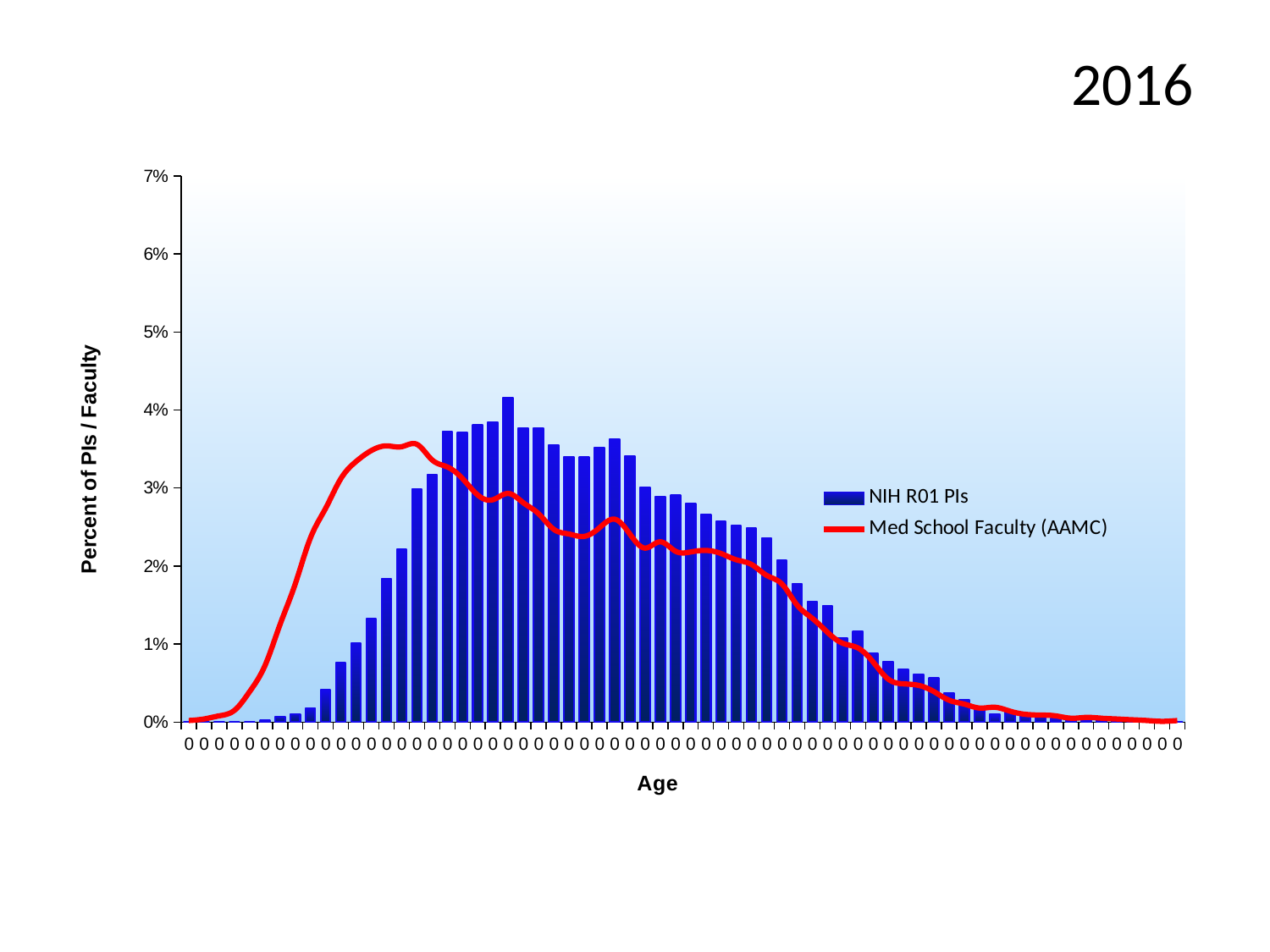
Toward the right end of the x axis, do the NIH R01 PIs bars rise or fall? fall What are the two series named in the legend? NIH R01 PIs and Med School Faculty (AAMC) What kind of chart is shown on the slide? A bar chart combined with a line chart What is the title of the vertical axis? Percent of PIs / Faculty Which series rises first along the x axis, the bars or the red line? Med School Faculty (AAMC) Is the peak of the Med School Faculty (AAMC) line greater or less than 3%? greater Which series is drawn as a red line rather than bars? Med School Faculty (AAMC) How many series does the legend list? 2 Is the tallest NIH R01 PIs bar greater or less than 4%? greater Which series reaches a higher peak value, NIH R01 PIs or Med School Faculty (AAMC)? NIH R01 PIs Is the peak of the Med School Faculty (AAMC) line greater or less than 4%? less